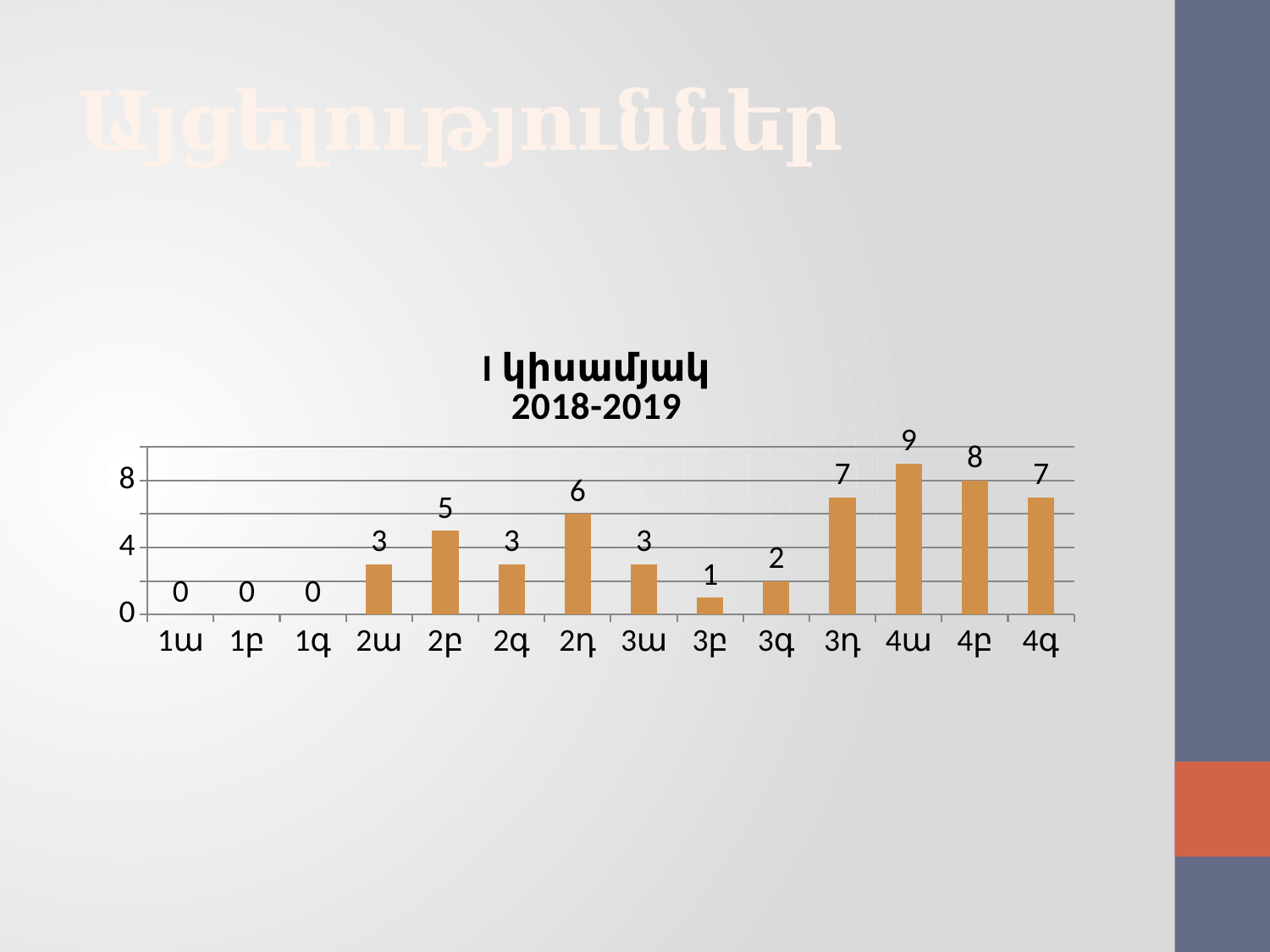
What is the difference between the values for 4բ and 2բ? 3 What is the value for 2դ? 6 What is the title of the chart? I կիսամյակ 2018-2019 What is the difference between the values for 4ա and 3գ? 7 Is the value for 4բ greater or less than 4? greater What is the value for 3բ? 1 What is the value for 1ա? 0 Which category has the highest value? 4ա What kind of chart is shown on the slide? bar chart What is the value for 4ա? 9 Which is larger, the value for 3դ or the value for 2դ? 3դ How many categories are shown on the x axis? 14